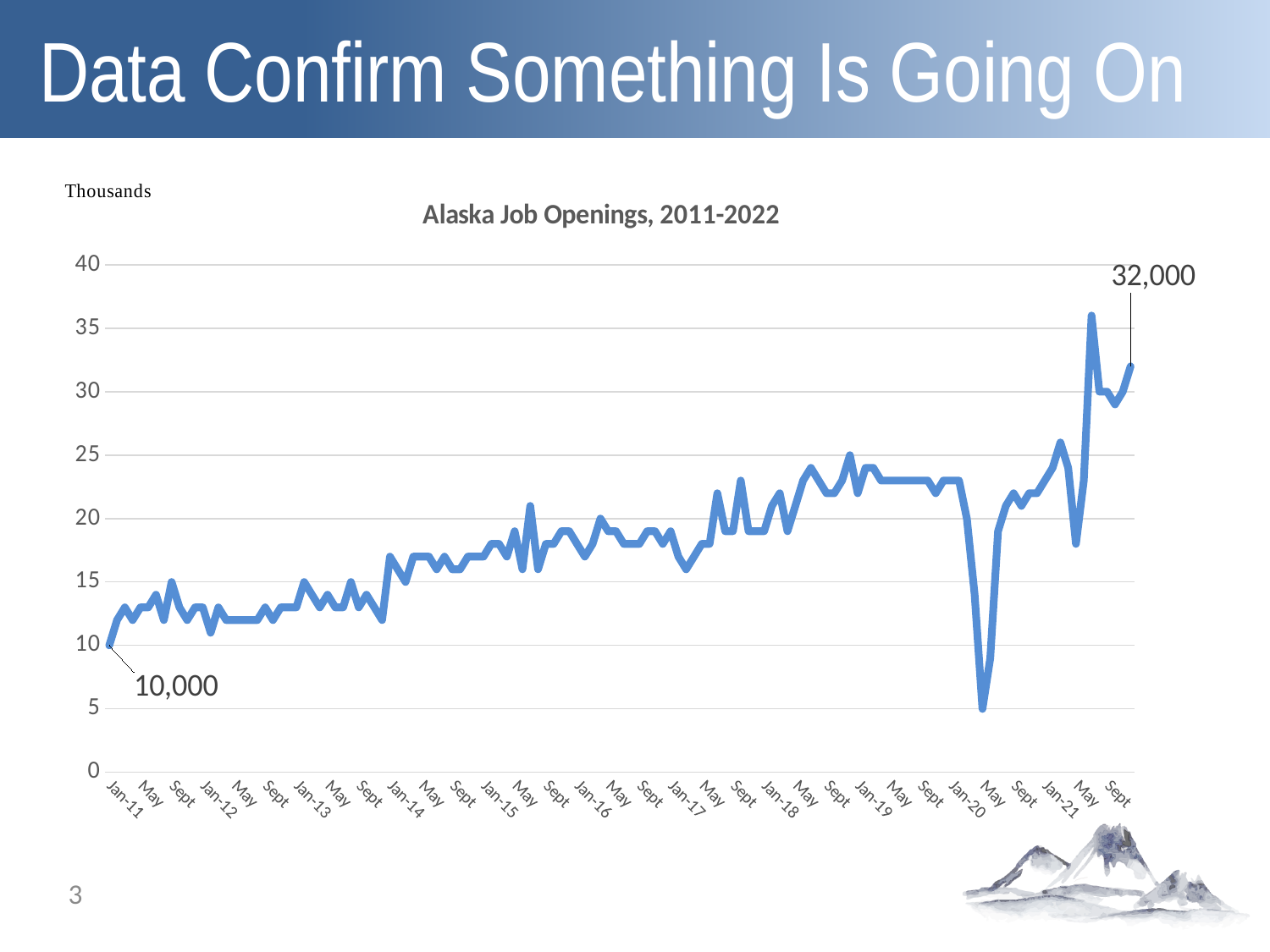
Overall, do job openings rise or fall from 2011 to 2022? rise What is the difference between the labelled end value (32,000) and the labelled start value (10,000)? 22,000 What is the labelled value of job openings at the end of the series in 2022? 32,000 Is the value at Jan-12 greater or less than 15? less In which year does the line reach its lowest point? 2020 What is the title of the chart? Alaska Job Openings, 2011-2022 Which is larger: the labelled value at Jan-11 or the labelled value at the end of 2022? the end of 2022 What is the labelled value of job openings at the start of the series (Jan-11)? 10,000 Is the value at the sharp dip around May-20 greater or less than 10? less What unit does the y-axis label indicate the values are in? Thousands Is the value at Jan-19 greater or less than 20? greater What kind of chart is shown on the slide? line chart